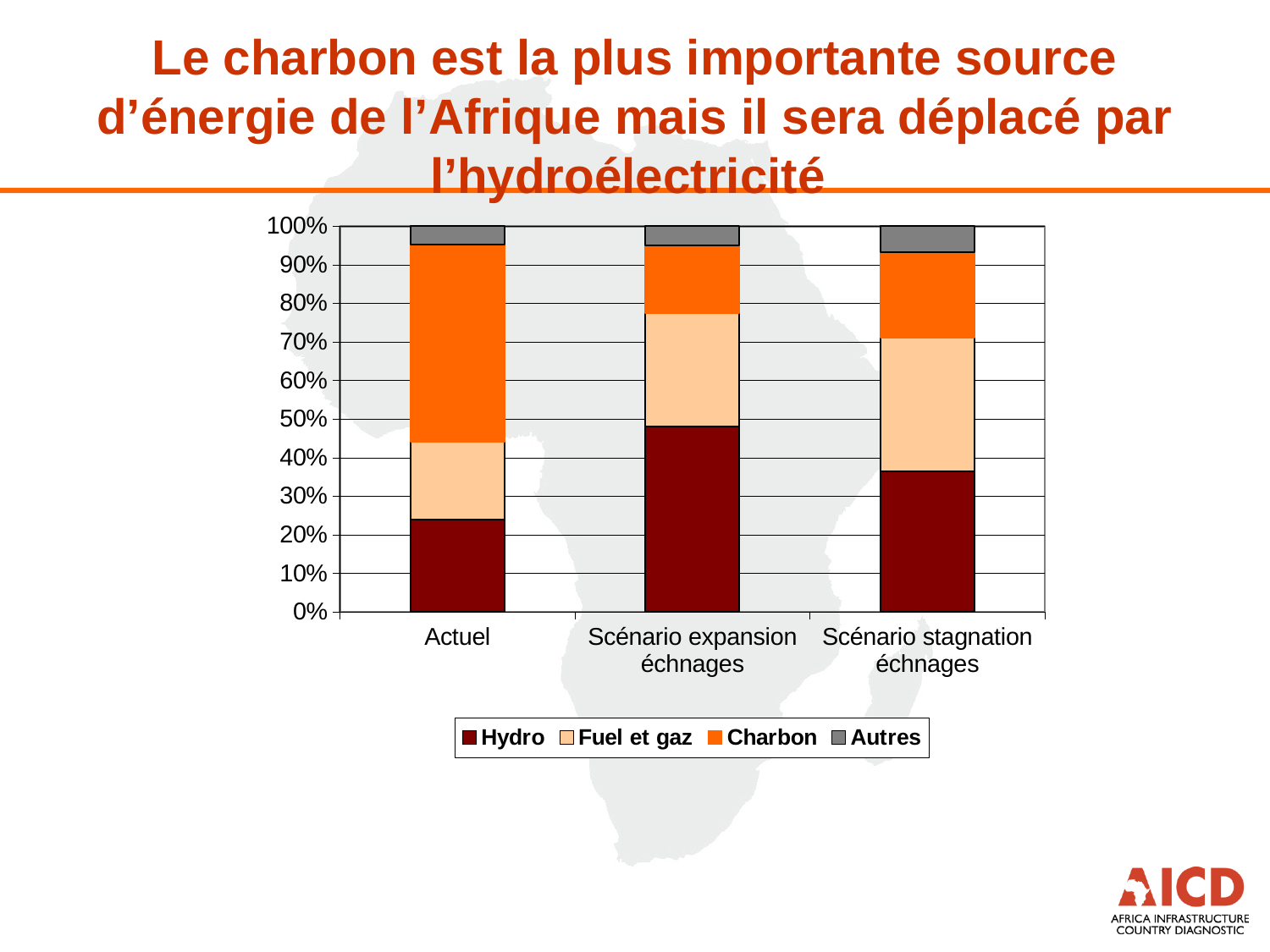
Is the Charbon share for Actuel greater or less than 40%? greater Which category has the largest Charbon share? Actuel Is the Hydro share for Scénario stagnation échnages greater or less than 30%? greater What kind of chart is shown on the slide? Stacked bar chart How many series does the chart's legend list? 4 Which category has the largest Hydro share? Scénario expansion échnages Which series are listed in the chart's legend? Hydro, Fuel et gaz, Charbon, Autres Which category has the smallest Hydro share? Actuel Is the Hydro share for Scénario expansion échnages greater or less than 40%? greater How many categories are shown on the x axis of the chart? 3 Which colour represents the Hydro series in the chart? Dark red